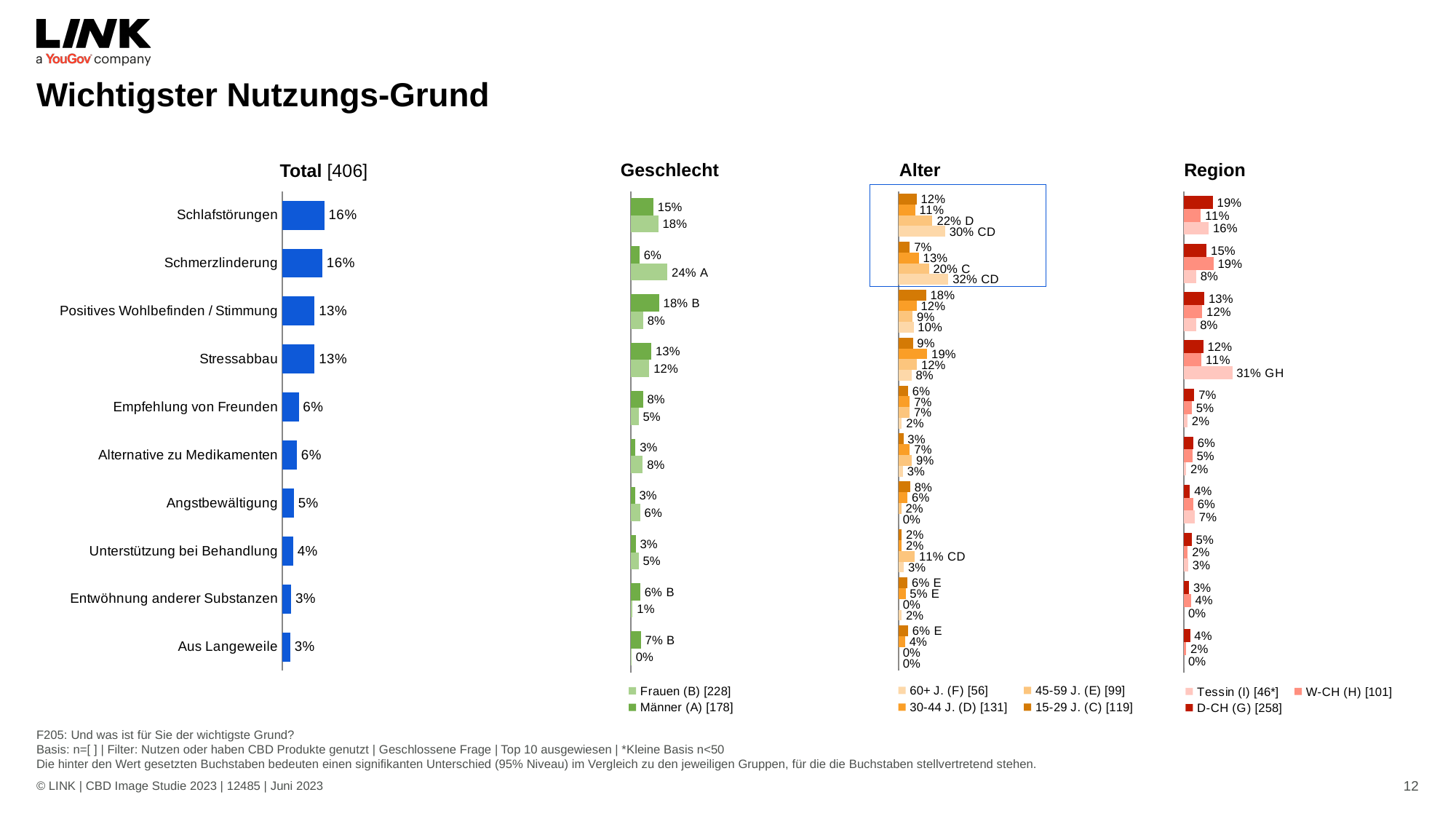
In the Alter chart, what is the value for 60+ J. for Schmerzlinderung? 32% In the Geschlecht chart, which is larger for Positives Wohlbefinden / Stimmung, Männer or Frauen? Männer In the Total chart, what is the value for Unterstützung bei Behandlung? 4% In the Total chart, how many categories are shown? 10 In the Geschlecht chart, what is the value for Frauen for Aus Langeweile? 0% What kind of chart is the Total chart? Bar chart In the Total chart, what is the value for Stressabbau? 13% In the Region chart, what is the value for D-CH for Schlafstörungen? 19% In the Geschlecht chart, what is the value for Frauen for Schmerzlinderung? 24% How many series does the legend of the Alter chart list? 4 In the Region chart, which region has the highest value for Stressabbau? Tessin In the Total chart, what is the difference between Schlafstörungen and Empfehlung von Freunden? 10 percentage points